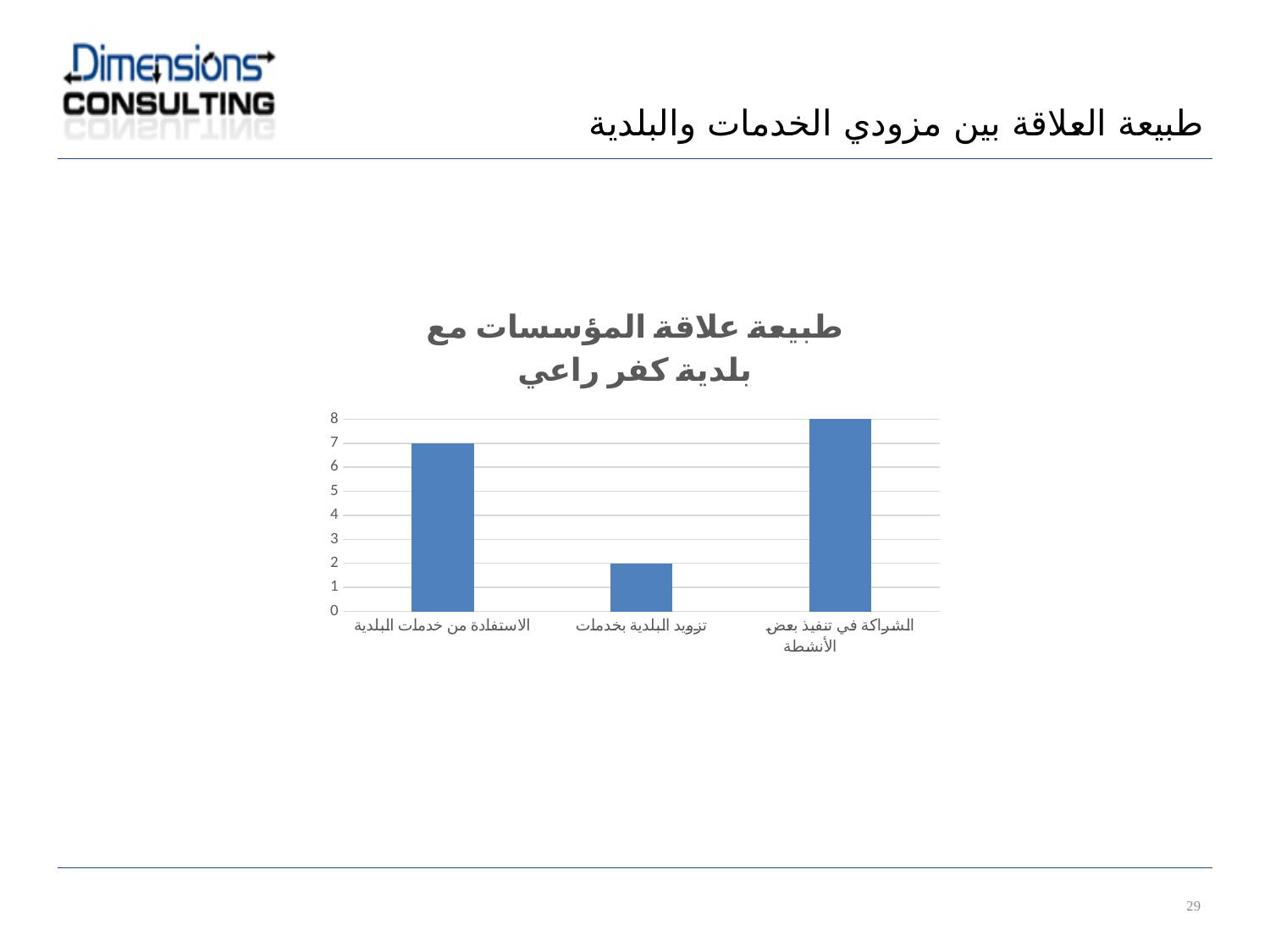
Which category has the lowest value? تزويد البلدية بخدمات What is the value for الشراكة في تنفيذ بعض الأنشطة? 8 What type of chart is shown on the slide? Bar chart Which category has the highest value? الشراكة في تنفيذ بعض الأنشطة What is the maximum value shown on the vertical axis of the chart? 8 What is the value for تزويد البلدية بخدمات? 2 Is the value for تزويد البلدية بخدمات greater or less than 5? less What is the difference between the values for الشراكة في تنفيذ بعض الأنشطة and تزويد البلدية بخدمات? 6 Which is larger, the value for الاستفادة من خدمات البلدية or the value for تزويد البلدية بخدمات? الاستفادة من خدمات البلدية How many categories are shown on the x axis of the chart? 3 What is the value for الاستفادة من خدمات البلدية? 7 What is the title of the chart? طبيعة علاقة المؤسسات مع بلدية كفر راعي